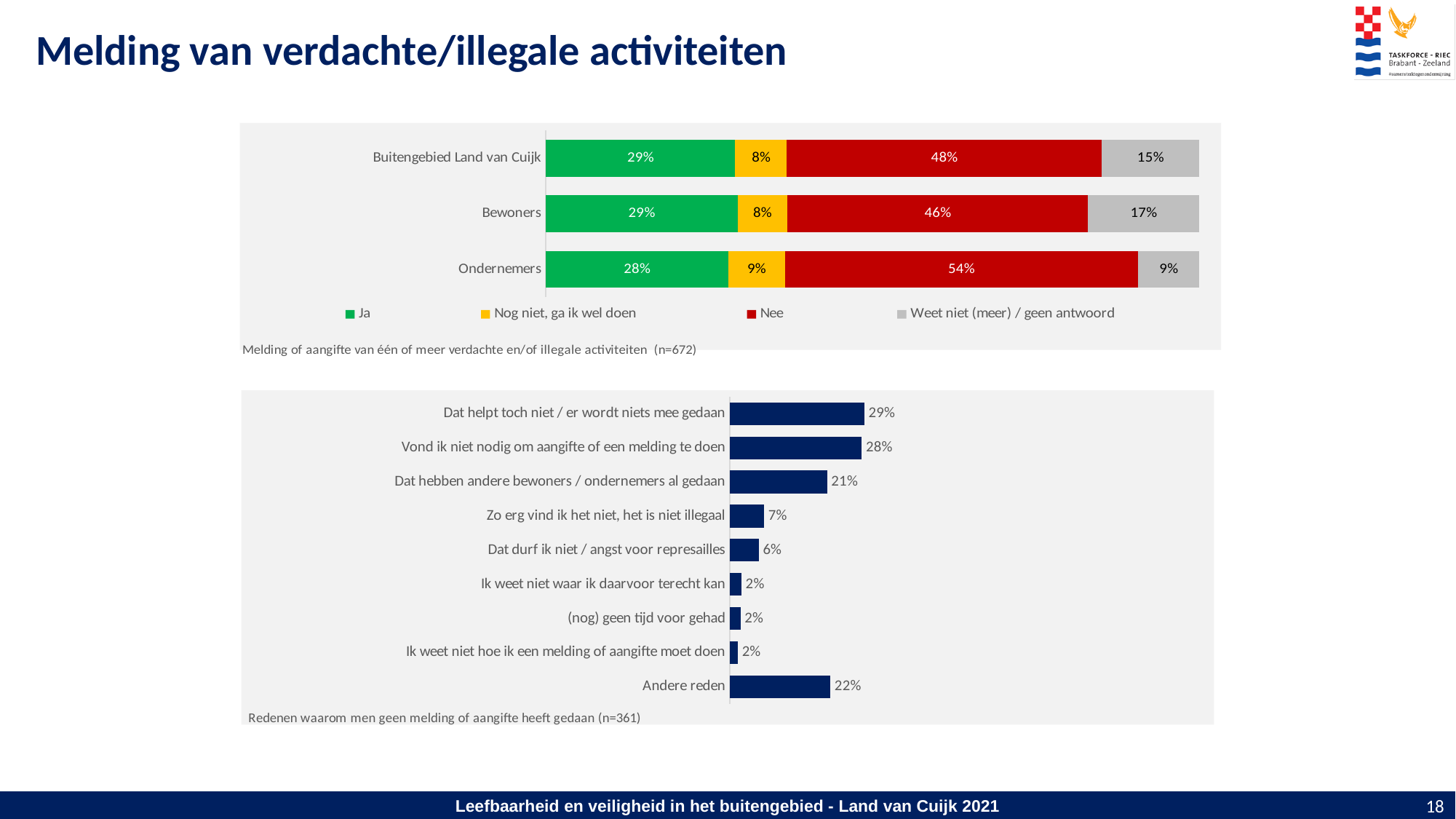
In the bottom chart (Redenen waarom men geen melding of aangifte heeft gedaan), what is the value for 'Dat durf ik niet / angst voor represailles'? 6% In the top chart (Melding of aangifte van één of meer verdachte en/of illegale activiteiten), how many series does the legend list? 4 In the top chart (Melding of aangifte van één of meer verdachte en/of illegale activiteiten), what is the difference between the 'Nee' values for Ondernemers and Bewoners? 8% In the top chart (Melding of aangifte van één of meer verdachte en/of illegale activiteiten), which category has the highest 'Nee' value? Ondernemers In the bottom chart (Redenen waarom men geen melding of aangifte heeft gedaan), what is the difference between 'Dat helpt toch niet / er wordt niets mee gedaan' and 'Zo erg vind ik het niet, het is niet illegaal'? 22% What kind of chart is the bottom chart (Redenen waarom men geen melding of aangifte heeft gedaan)? Bar chart In the bottom chart (Redenen waarom men geen melding of aangifte heeft gedaan), how many categories are shown? 9 In the bottom chart (Redenen waarom men geen melding of aangifte heeft gedaan), which is larger: 'Dat hebben andere bewoners / ondernemers al gedaan' or 'Andere reden'? Andere reden In the bottom chart (Redenen waarom men geen melding of aangifte heeft gedaan), which reason has the highest value? Dat helpt toch niet / er wordt niets mee gedaan In the top chart (Melding of aangifte van één of meer verdachte en/of illegale activiteiten), what is the 'Weet niet (meer) / geen antwoord' value for Bewoners? 17% In the top chart (Melding of aangifte van één of meer verdachte en/of illegale activiteiten), what is the total of the stacked bar for Buitengebied Land van Cuijk? 100% In the top chart (Melding of aangifte van één of meer verdachte en/of illegale activiteiten), what is the 'Nee' value for Ondernemers? 54%